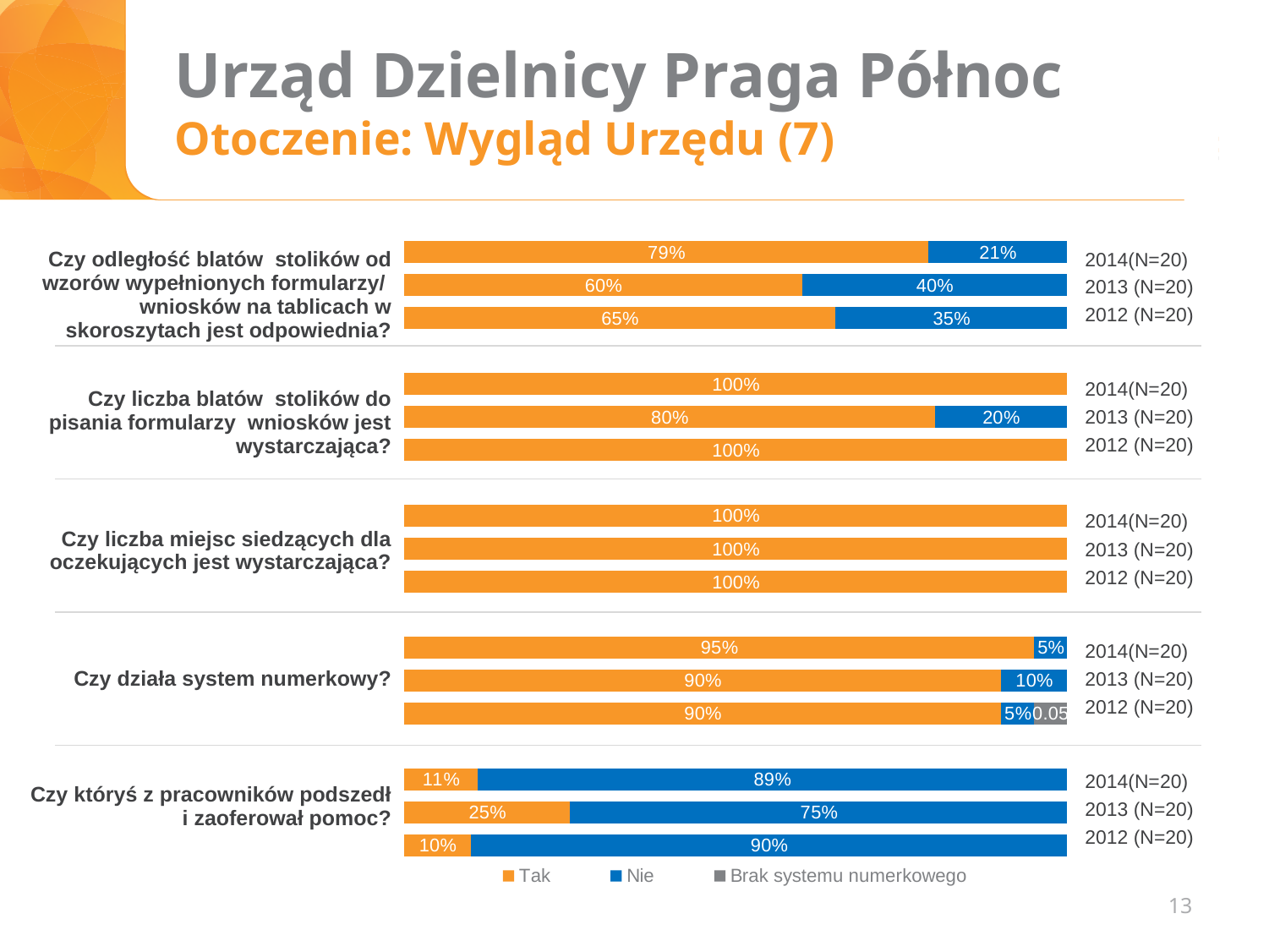
In the chart for "Czy działa system numerkowy?", what is the Tak value for 2014 (N=20)? 95% In the chart for "Czy odległość blatów stolików od wzorów wypełnionych formularzy/wniosków na tablicach w skoroszytach jest odpowiednia?", which year has the highest Tak value? 2014(N=20) In the chart for "Czy liczba blatów stolików do pisania formularzy wniosków jest wystarczająca?", what is the Nie value for 2013 (N=20)? 20% What kind of chart is used on this slide? Stacked bar chart In the chart for "Czy któryś z pracowników podszedł i zaoferował pomoc?", which is larger: the Tak value for 2013 or the Tak value for 2014? 2013 (N=20) In the chart for "Czy odległość blatów stolików od wzorów wypełnionych formularzy/wniosków na tablicach w skoroszytach jest odpowiednia?", what is the Nie value for 2013 (N=20)? 40% How many bars are shown in the chart for "Czy liczba miejsc siedzących dla oczekujących jest wystarczająca?"? 3 How many series does the legend at the bottom of the slide list? 3 In the chart for "Czy odległość blatów stolików od wzorów wypełnionych formularzy/wniosków na tablicach w skoroszytach jest odpowiednia?", what is the Tak value for 2014 (N=20)? 79% In the chart for "Czy odległość blatów stolików od wzorów wypełnionych formularzy/wniosków na tablicach w skoroszytach jest odpowiednia?", what is the difference between the Tak values for 2014 and 2013? 19% In the chart for "Czy któryś z pracowników podszedł i zaoferował pomoc?", which year has the lowest Tak value? 2012 (N=20) In the chart for "Czy któryś z pracowników podszedł i zaoferował pomoc?", what is the Nie value for 2012 (N=20)? 90%